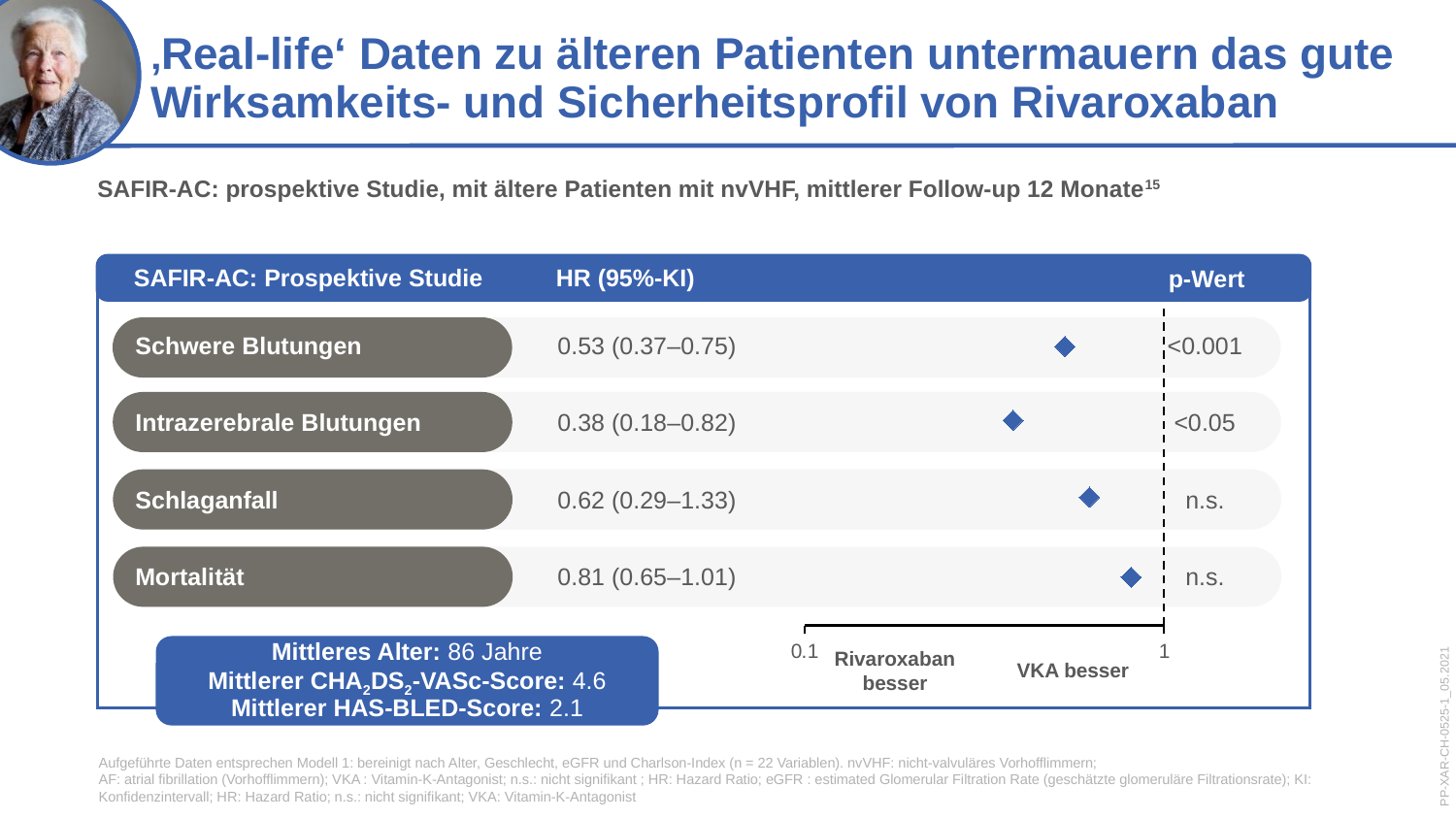
What is the difference between the hazard ratios for Mortalität and Intrazerebrale Blutungen? 0.43 What p-value is shown for Schwere Blutungen? <0.001 What is the HR (95%-KI) shown for Schlaganfall? 0.62 (0.29–1.33) What is the hazard ratio (HR) for Schwere Blutungen? 0.53 What p-value is shown for Mortalität? n.s. Is the hazard ratio for Mortalität greater or less than 1? less What is the 95% confidence interval shown for Intrazerebrale Blutungen? 0.18–0.82 Which outcome has the highest hazard ratio? Mortalität How many outcomes are plotted in the chart? 4 Which outcome has the lowest hazard ratio? Intrazerebrale Blutungen What kind of chart is shown on the slide? Forest plot Which has the larger hazard ratio, Schlaganfall or Schwere Blutungen? Schlaganfall